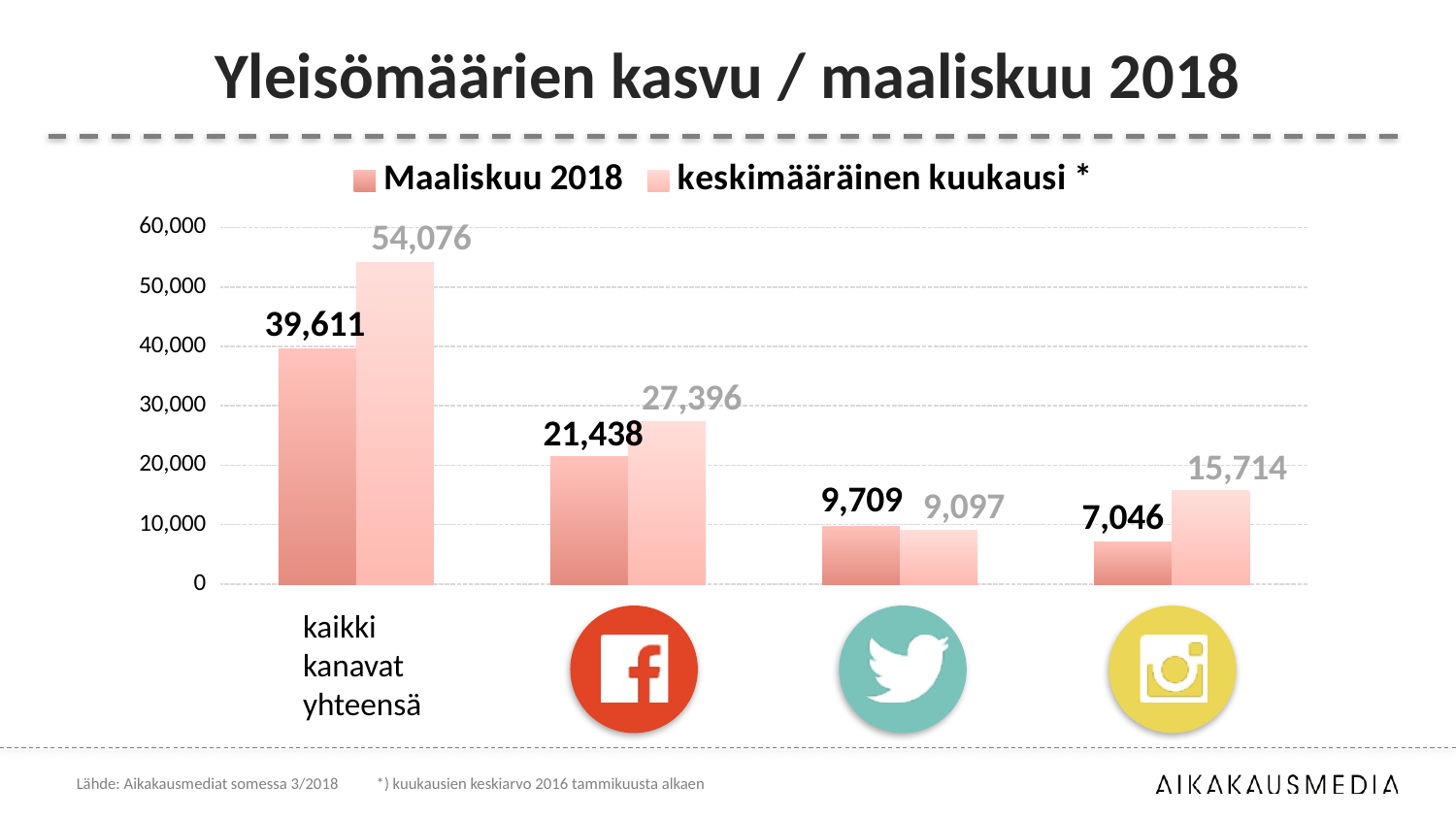
What is the value for 'keskimääräinen kuukausi *' for the category 'kaikki kanavat yhteensä'? 54,076 How many series does the chart legend list? 2 What type of chart is shown on the slide? bar chart What is the 'keskimääräinen kuukausi *' value for the Instagram category? 15,714 What is the difference between the 'keskimääräinen kuukausi *' value and the Maaliskuu 2018 value for the Facebook category? 5,958 Is the Maaliskuu 2018 value for the Instagram category greater or less than 10,000? less How many categories are shown on the x axis of the chart? 4 For the Twitter category, which is larger: the Maaliskuu 2018 value or the 'keskimääräinen kuukausi *' value? Maaliskuu 2018 Which category has the lowest Maaliskuu 2018 value? Instagram Which category has the highest 'keskimääräinen kuukausi *' value? kaikki kanavat yhteensä What is the value for Maaliskuu 2018 for the category 'kaikki kanavat yhteensä'? 39,611 What is the Maaliskuu 2018 value for the Facebook category? 21,438